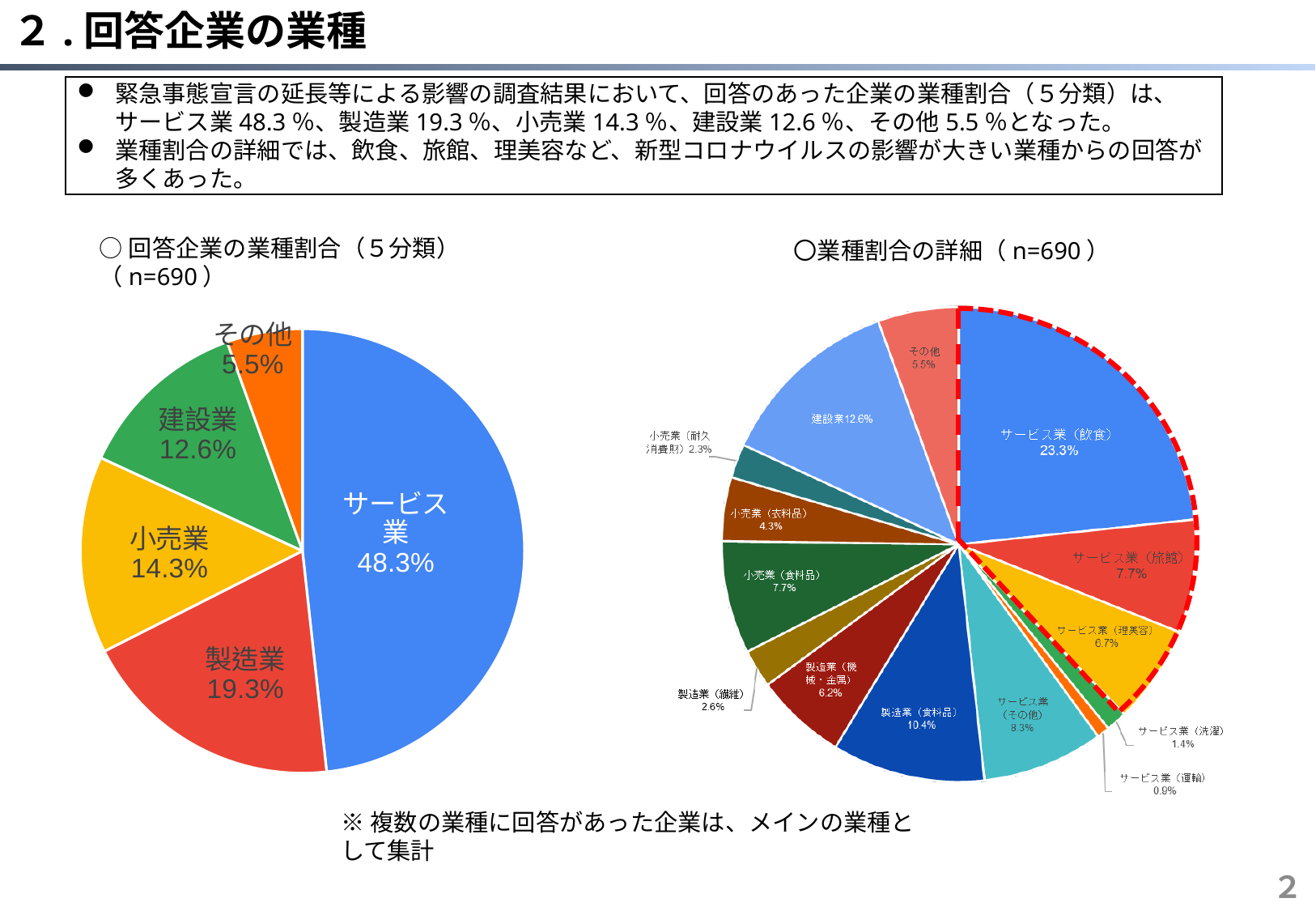
In the left pie chart (回答企業の業種割合（5分類）), what is the difference in percentage points between 製造業 and 建設業? 6.7 In the left pie chart (回答企業の業種割合（5分類）), what share does サービス業 have? 48.3% In the right pie chart (業種割合の詳細), what share does 製造業（食料品） have? 10.4% In the right pie chart (業種割合の詳細), how many slices are shown? 14 In the right pie chart (業種割合の詳細), which category has the smallest share? サービス業（運輸） What type of chart is used for 業種割合の詳細 on the right? Pie chart In the left pie chart (回答企業の業種割合（5分類）), which category has the largest share? サービス業 In the left pie chart (回答企業の業種割合（5分類）), which category has the smallest share? その他 In the right pie chart (業種割合の詳細), which is larger: サービス業（理美容） or 小売業（衣料品）? サービス業（理美容） In the right pie chart (業種割合の詳細), what share does サービス業（飲食） have? 23.3% In the left pie chart (回答企業の業種割合（5分類）), how many categories are shown? 5 In the left pie chart (回答企業の業種割合（5分類）), what share does 小売業 have? 14.3%